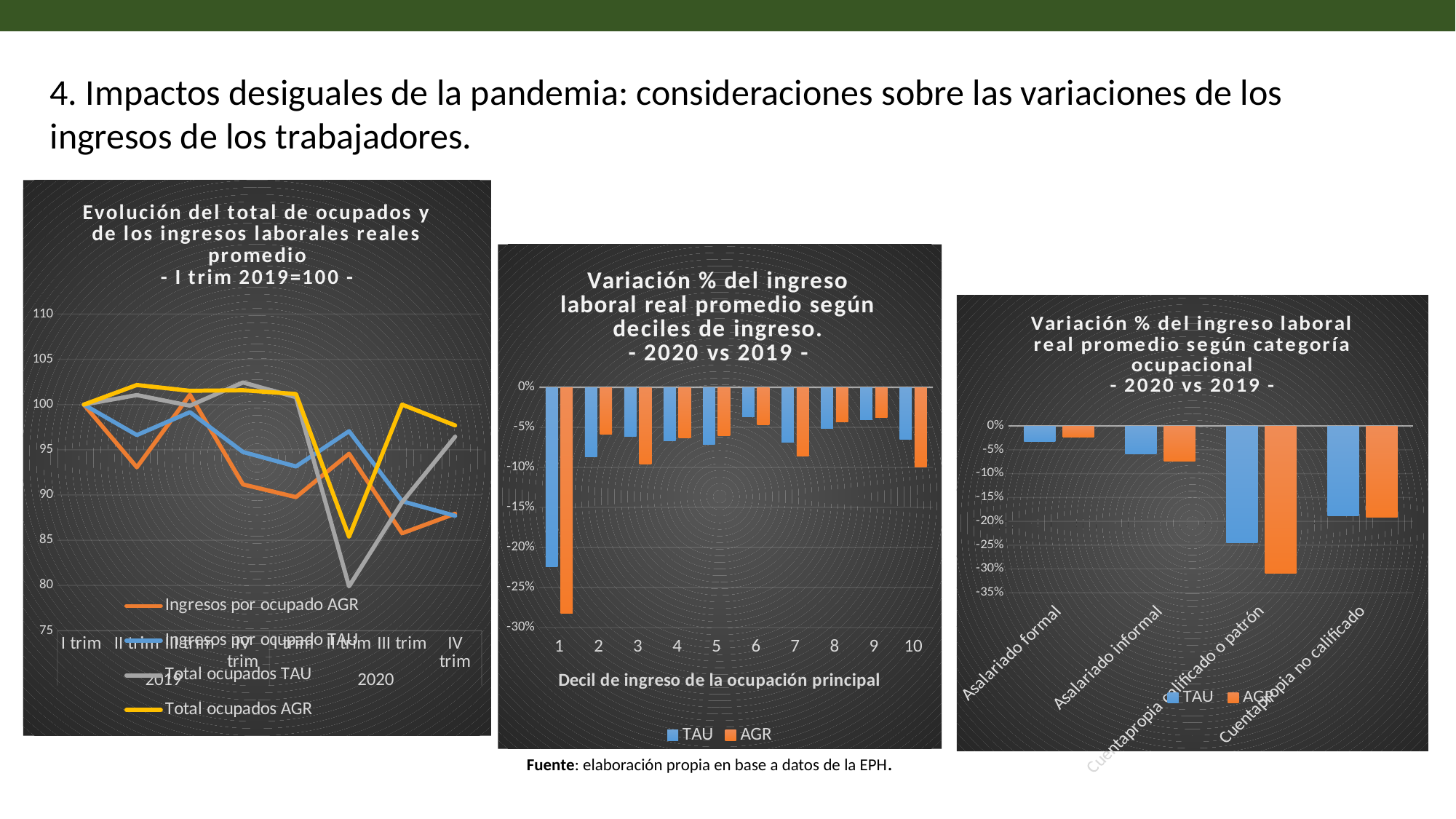
How many series does the legend of the left chart ('Evolución del total de ocupados...') list? 4 How many deciles are shown on the x axis of the middle chart ('Variación % ... según deciles de ingreso')? 10 In the middle chart ('Variación % ... según deciles de ingreso'), is the AGR value for decile 1 greater or less than -25%? less In the right chart ('Variación % ... según categoría ocupacional'), which category shows the largest decline for AGR? Cuentapropia calificado o patrón How many occupational categories are shown in the right chart ('Variación % ... según categoría ocupacional')? 4 In the left chart ('Evolución del total de ocupados...'), is the value of Total ocupados TAU at II trim 2020 greater or less than 85? less What kind of chart is the middle chart titled 'Variación % del ingreso laboral real promedio según deciles de ingreso'? Bar chart In the left chart ('Evolución del total de ocupados...'), which series reaches the lowest point on the chart? Total ocupados TAU In the middle chart ('Variación % ... según deciles de ingreso'), for decile 1, which series shows the larger decline, TAU or AGR? AGR What kind of chart is the left chart titled 'Evolución del total de ocupados y de los ingresos laborales reales promedio'? Line chart In the middle chart ('Variación % ... según deciles de ingreso'), which decile shows the largest decline for AGR? 1 In the left chart ('Evolución del total de ocupados...'), what is the base period indicated in the title as equal to 100? I trim 2019